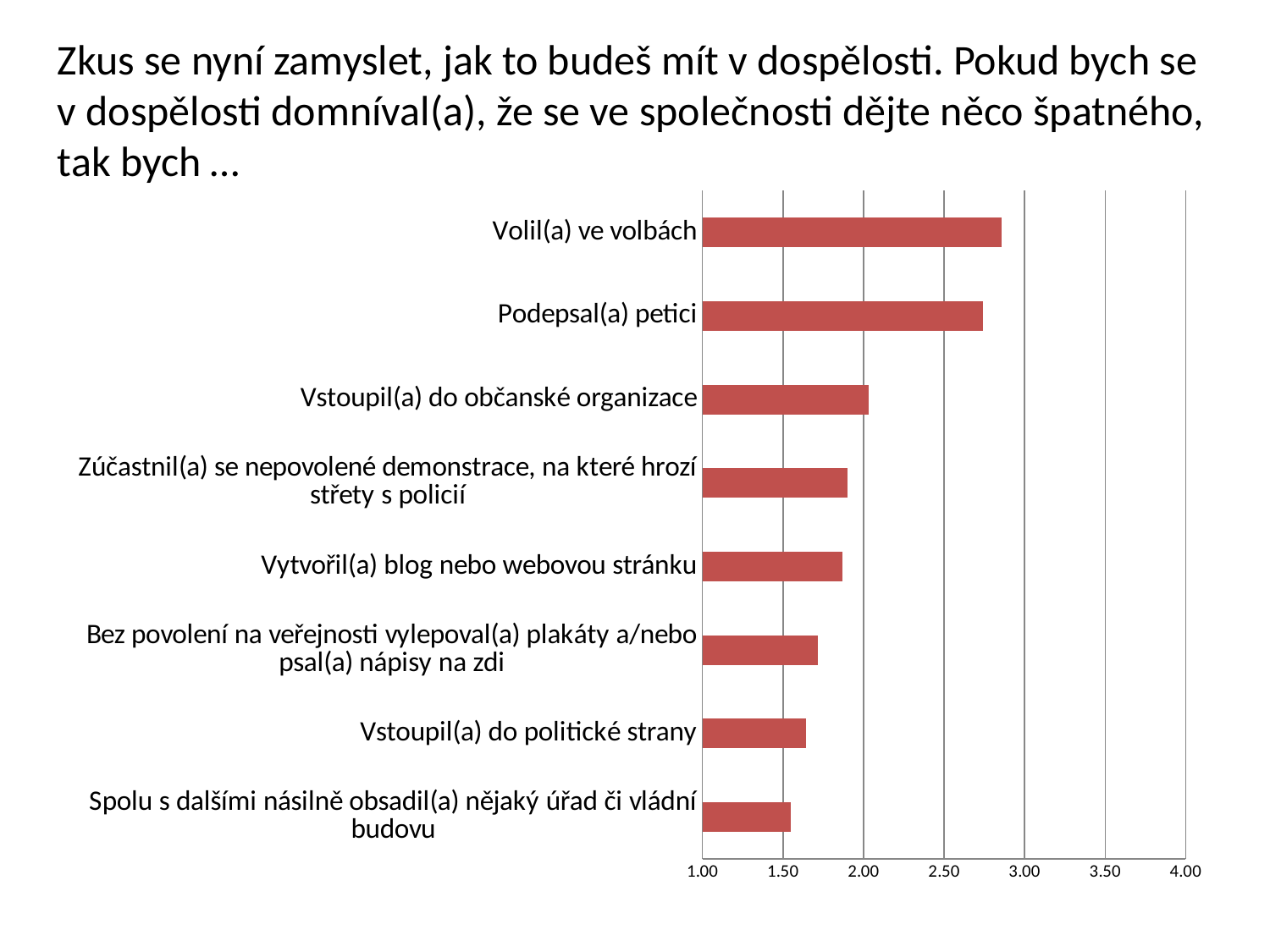
Is the value for Vytvořil(a) blog nebo webovou stránku greater or less than 2.00? less Which category has the lowest value in the chart? Spolu s dalšími násilně obsadil(a) nějaký úřad či vládní budovu Is the value for Vstoupil(a) do občanské organizace greater or less than 2.50? less Is the value for Podepsal(a) petici greater or less than 2.50? greater What kind of chart is shown on the slide? bar chart Which has the larger value: Vstoupil(a) do občanské organizace or Vstoupil(a) do politické strany? Vstoupil(a) do občanské organizace What is the maximum value shown on the horizontal axis of the chart? 4.00 Which category has the highest value in the chart? Volil(a) ve volbách How many categories are plotted in the chart? 8